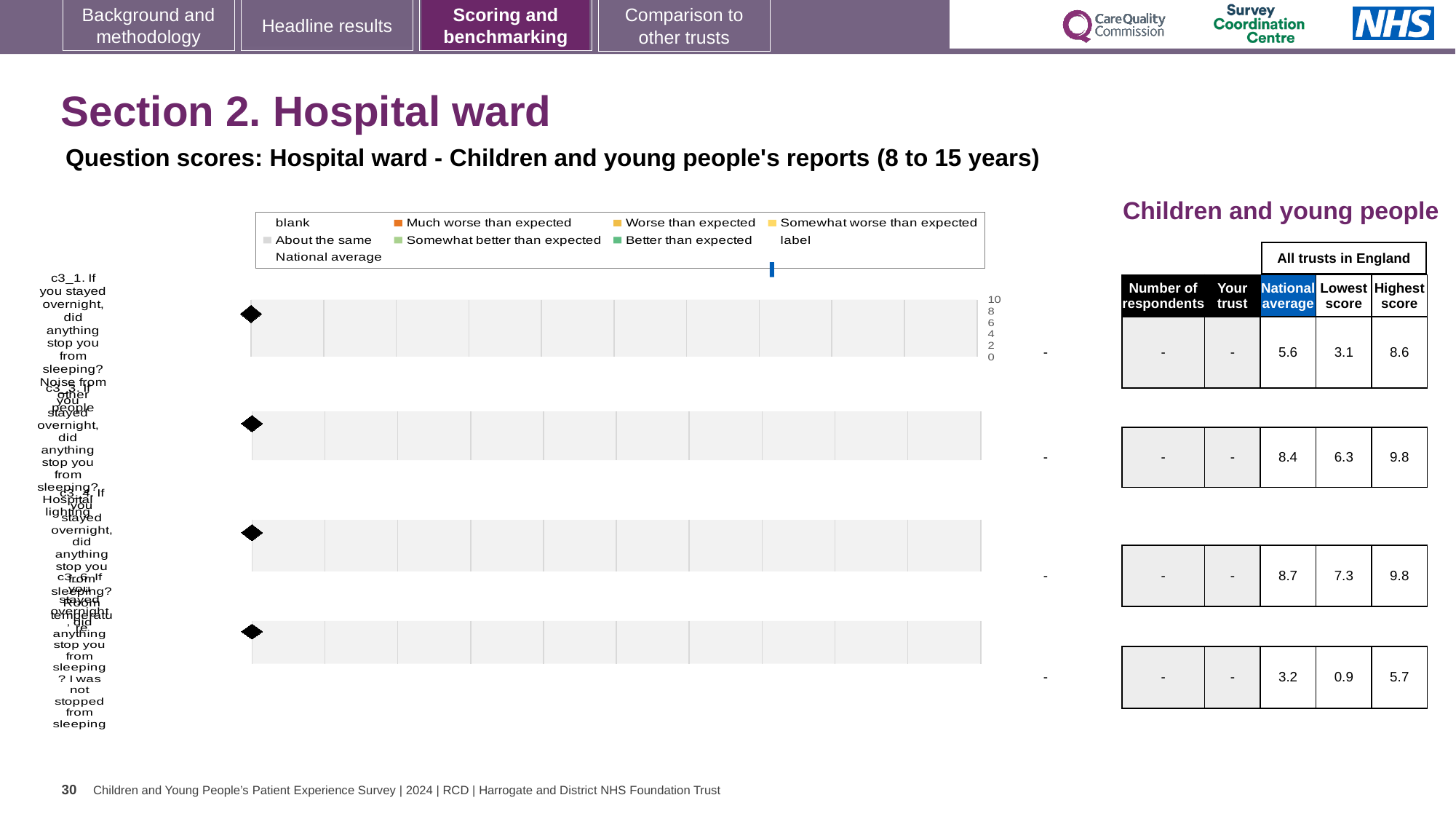
Which table row has the highest National average value? the third row (8.7) How many separate charts are shown on the slide? 4 Which table row has the lowest National average value? the bottom row (3.2) Is the National average in the second table row larger or smaller than the National average in the first table row? larger What is the highest value shown on the axis of the top chart? 10 In the table next to the third chart, what is the Lowest score? 7.3 In the table next to the bottom chart, what is the National average? 3.2 What kind of chart is used for the four charts on the slide? bar chart In the table next to the top chart, what is the National average for the first row? 5.6 What is the first legend entry after 'blank' in the chart legend? Much worse than expected In the table next to the second chart, what is the Highest score? 9.8 What is the difference between the Highest score and Lowest score in the first table row? 5.5